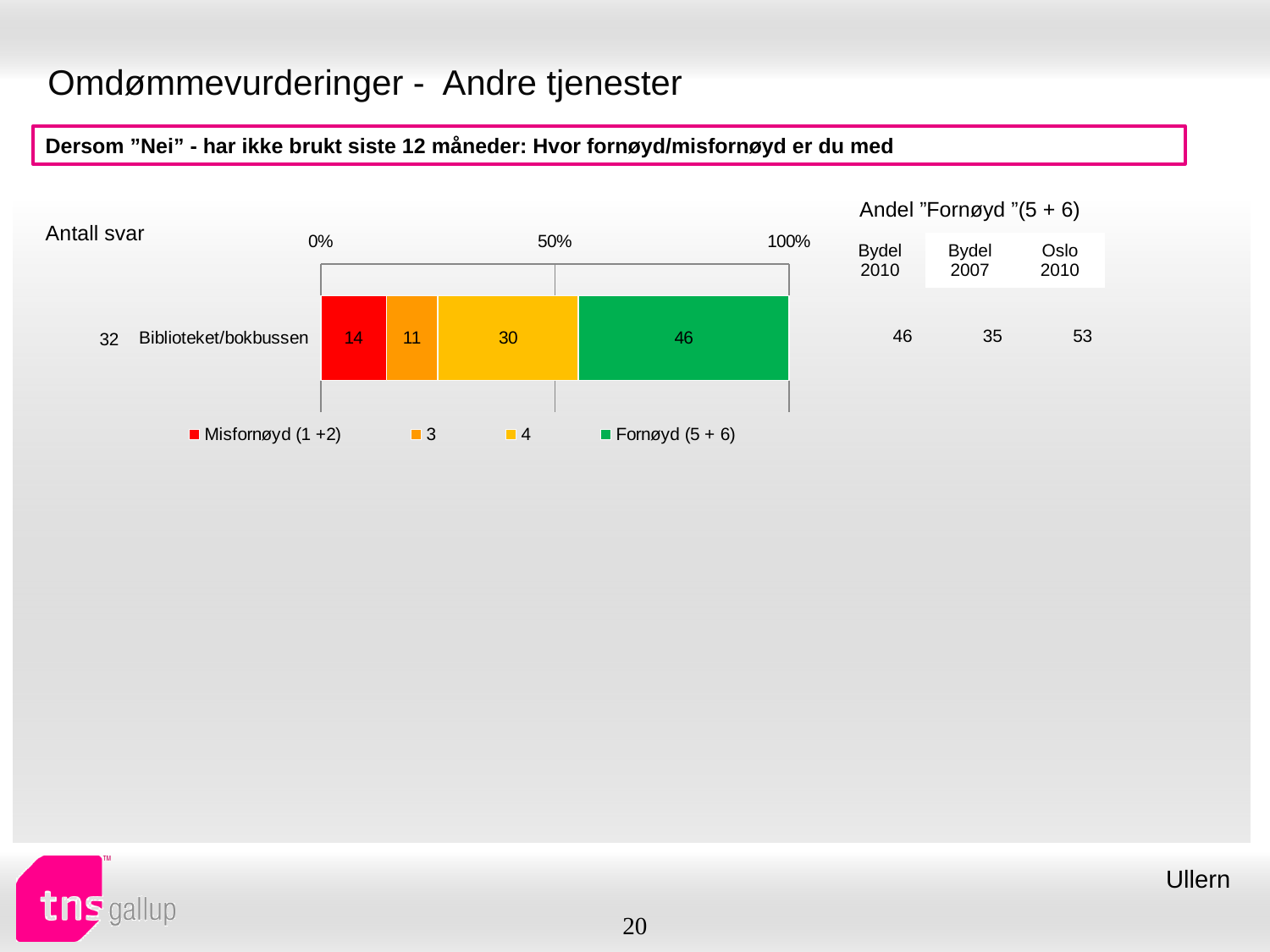
What kind of chart is shown on the slide? Stacked bar chart What is the value of the Misfornøyd (1 +2) segment for Biblioteket/bokbussen? 14 Which series has the largest segment in the Biblioteket/bokbussen bar? Fornøyd (5 + 6) What is the value of the segment labelled 4 for Biblioteket/bokbussen? 30 How many categories are plotted in the chart? 1 Which is larger for Biblioteket/bokbussen: the segment labelled 4 or the Misfornøyd (1 +2) segment? 4 How many series does the legend list? 4 Which series has the smallest segment in the Biblioteket/bokbussen bar? 3 What is the value of the segment labelled 3 for Biblioteket/bokbussen? 11 What is the difference between the Fornøyd (5 + 6) segment and the Misfornøyd (1 +2) segment for Biblioteket/bokbussen? 32 What is the value of the Fornøyd (5 + 6) segment for Biblioteket/bokbussen? 46 What is the difference between the segment labelled 4 and the segment labelled 3 for Biblioteket/bokbussen? 19